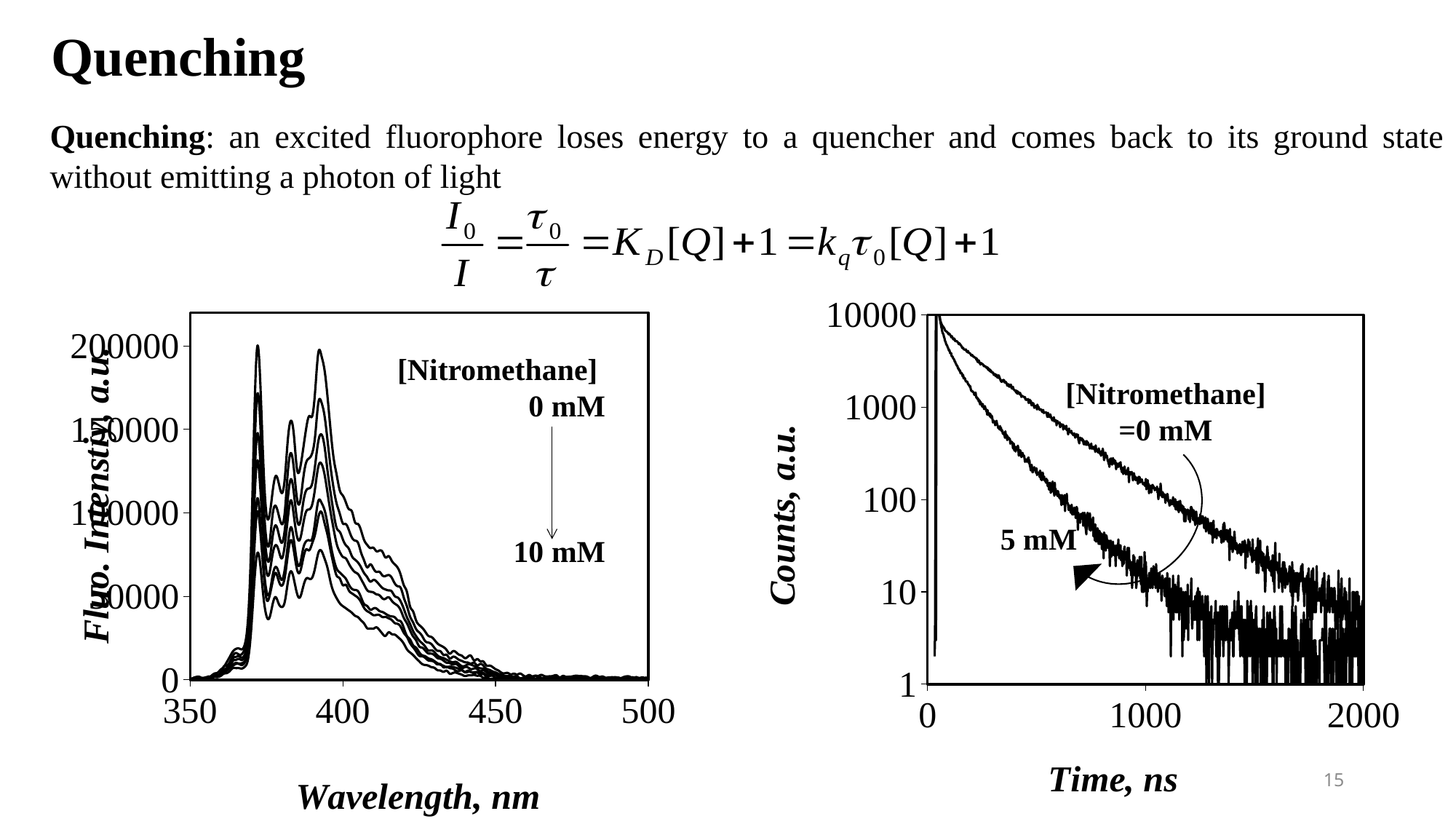
What kind of chart is the right chart (Counts vs Time)? line chart In the left chart, what is the x-axis label? Wavelength, nm What kind of chart is the left chart (Fluo. Intensity vs Wavelength)? line chart In the left chart, is the intensity at 500 nm greater or less than 50000? less In the left chart, does the fluorescence intensity rise or fall as the nitromethane concentration increases from 0 mM to 10 mM? fall In the left chart, which nitromethane concentration gives the highest fluorescence intensity? 0 mM In the left chart, which nitromethane concentration gives the lowest fluorescence intensity? 10 mM In the right chart, which curve has higher counts at 1000 ns, 0 mM or 5 mM? 0 mM In the right chart, do the counts rise or fall as time increases? fall In the left chart, is the peak intensity of the 0 mM curve greater or less than 150000? greater In the right chart, how many nitromethane concentrations are plotted? 2 In the right chart, what is the y-axis label? Counts, a.u.